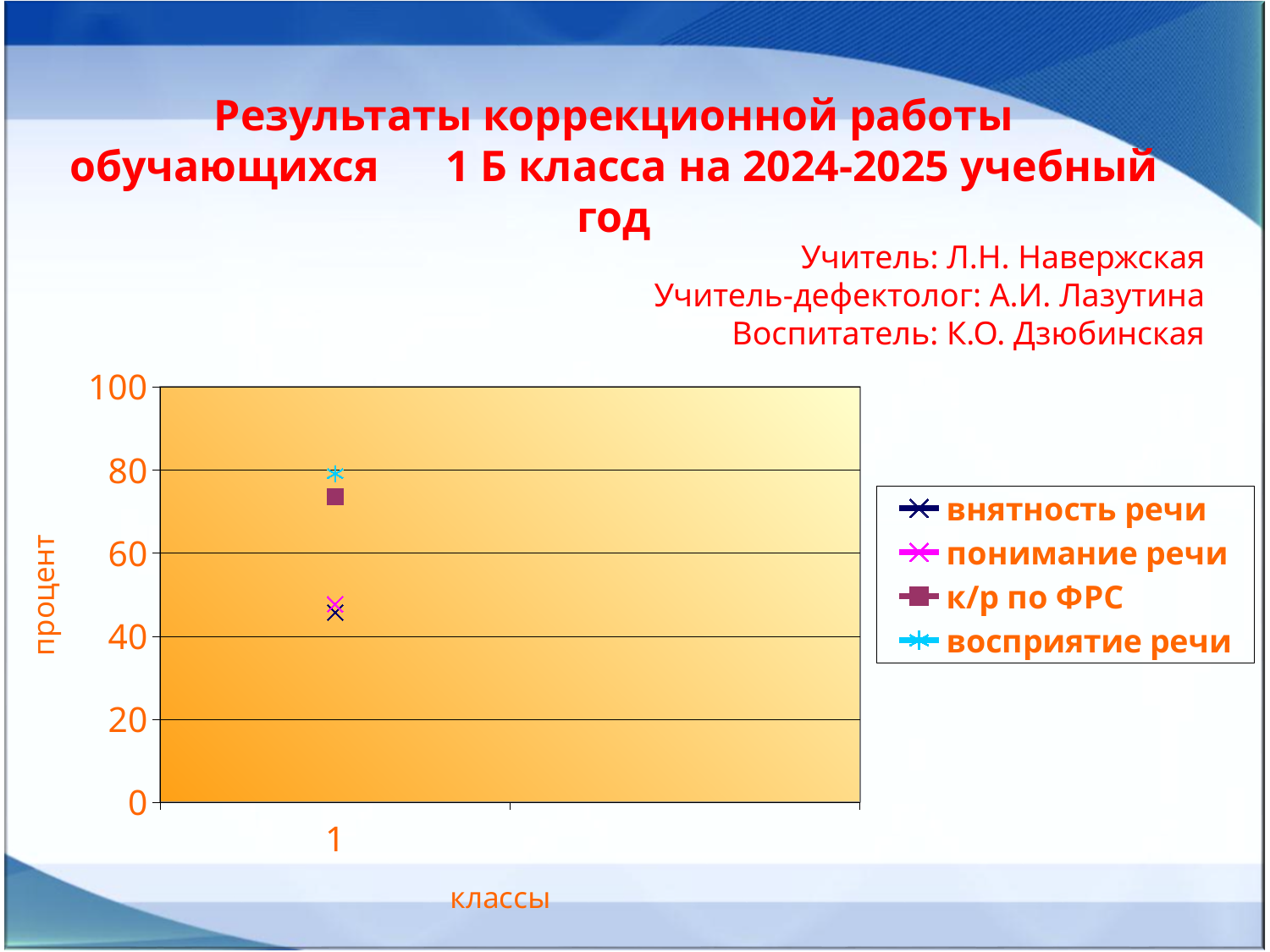
Is the value for восприятие речи greater or less than 60? greater Which series has the highest value for class 1? восприятие речи Which is larger for class 1: к/р по ФРС or внятность речи? к/р по ФРС Is the value for внятность речи greater or less than 40? greater Is the value for к/р по ФРС greater or less than 80? less How many categories are shown on the x axis? 1 What is the label of the vertical axis? процент What is the label of the horizontal axis? классы How many series does the legend list? 4 Which is larger for class 1: восприятие речи or понимание речи? восприятие речи